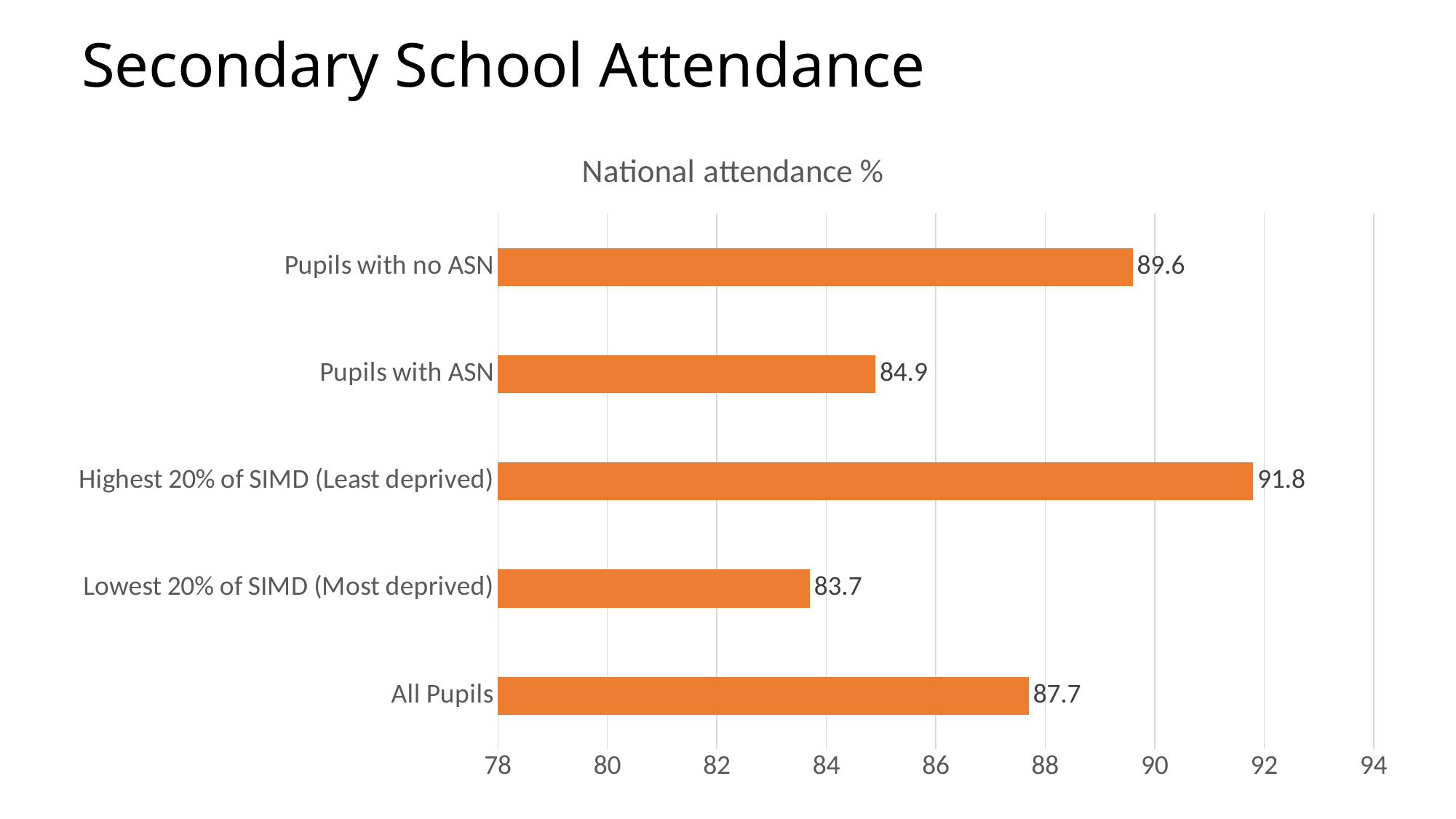
Which category has the highest national attendance %? Highest 20% of SIMD (Least deprived) Which category has the lowest national attendance %? Lowest 20% of SIMD (Most deprived) What is the national attendance % for Pupils with ASN? 84.9 What is the difference in national attendance % between Pupils with no ASN and Pupils with ASN? 4.7 How many categories are shown in the chart? 5 What is the national attendance % for the Lowest 20% of SIMD (Most deprived)? 83.7 What is the national attendance % for All Pupils? 87.7 What is the difference in national attendance % between the Highest 20% of SIMD and the Lowest 20% of SIMD? 8.1 What is the national attendance % for the Highest 20% of SIMD (Least deprived)? 91.8 Which has a higher national attendance %, All Pupils or Pupils with ASN? All Pupils What type of chart is shown on the slide? Bar chart What is the national attendance % for Pupils with no ASN? 89.6